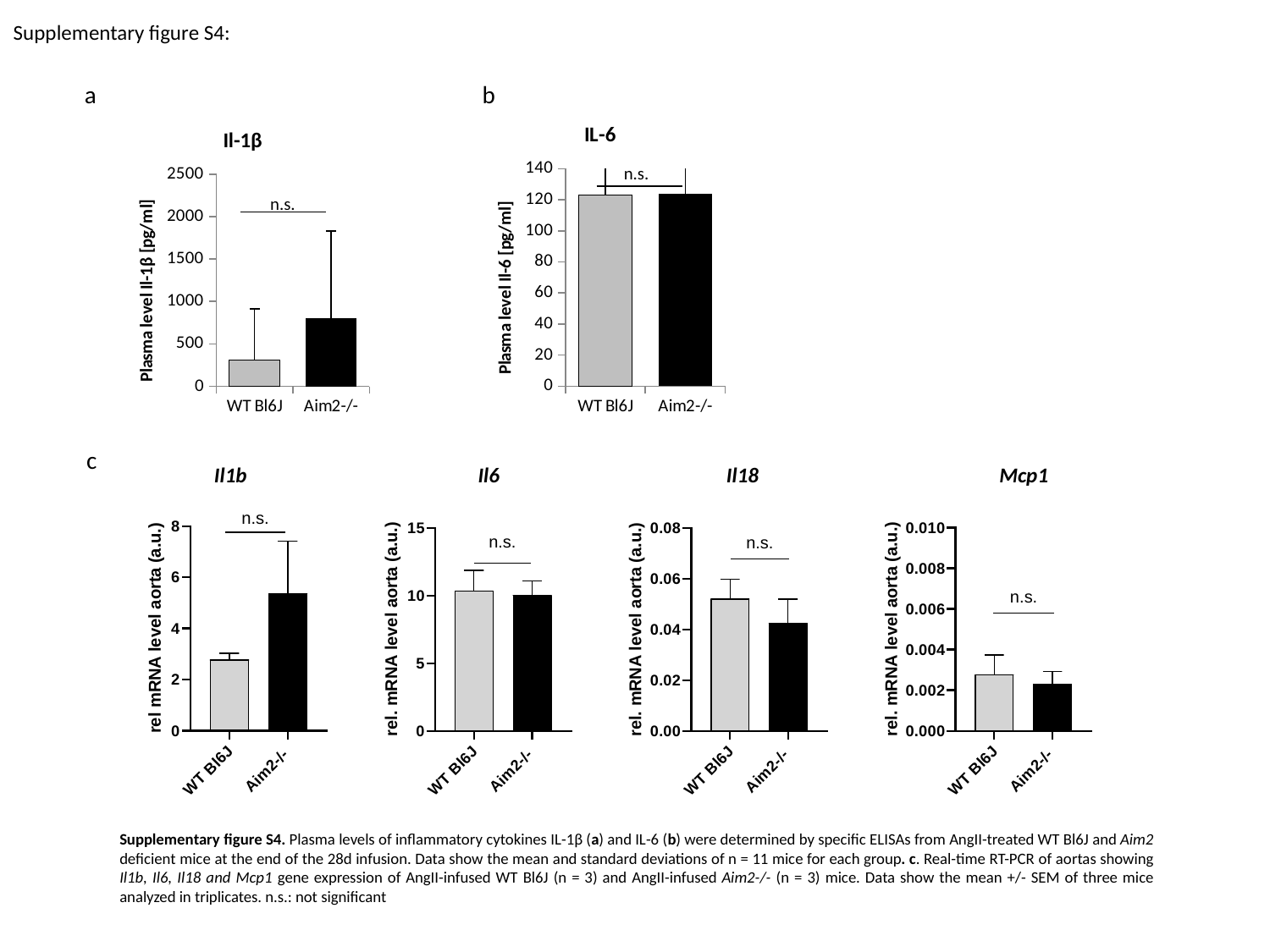
What kind of chart is the IL-6 chart? bar chart In the Il-1β chart, is the value for WT Bl6J greater or less than 500? less In the Il18 chart, is the value for WT Bl6J greater or less than 0.04? greater In the IL-6 chart, is the value for WT Bl6J greater or less than 100? greater In the Il-1β chart, which group has the higher plasma level, WT Bl6J or Aim2-/-? Aim2-/- How many bars are shown in the Mcp1 chart? 2 In the Il1b chart, which group has the higher mRNA level? Aim2-/-